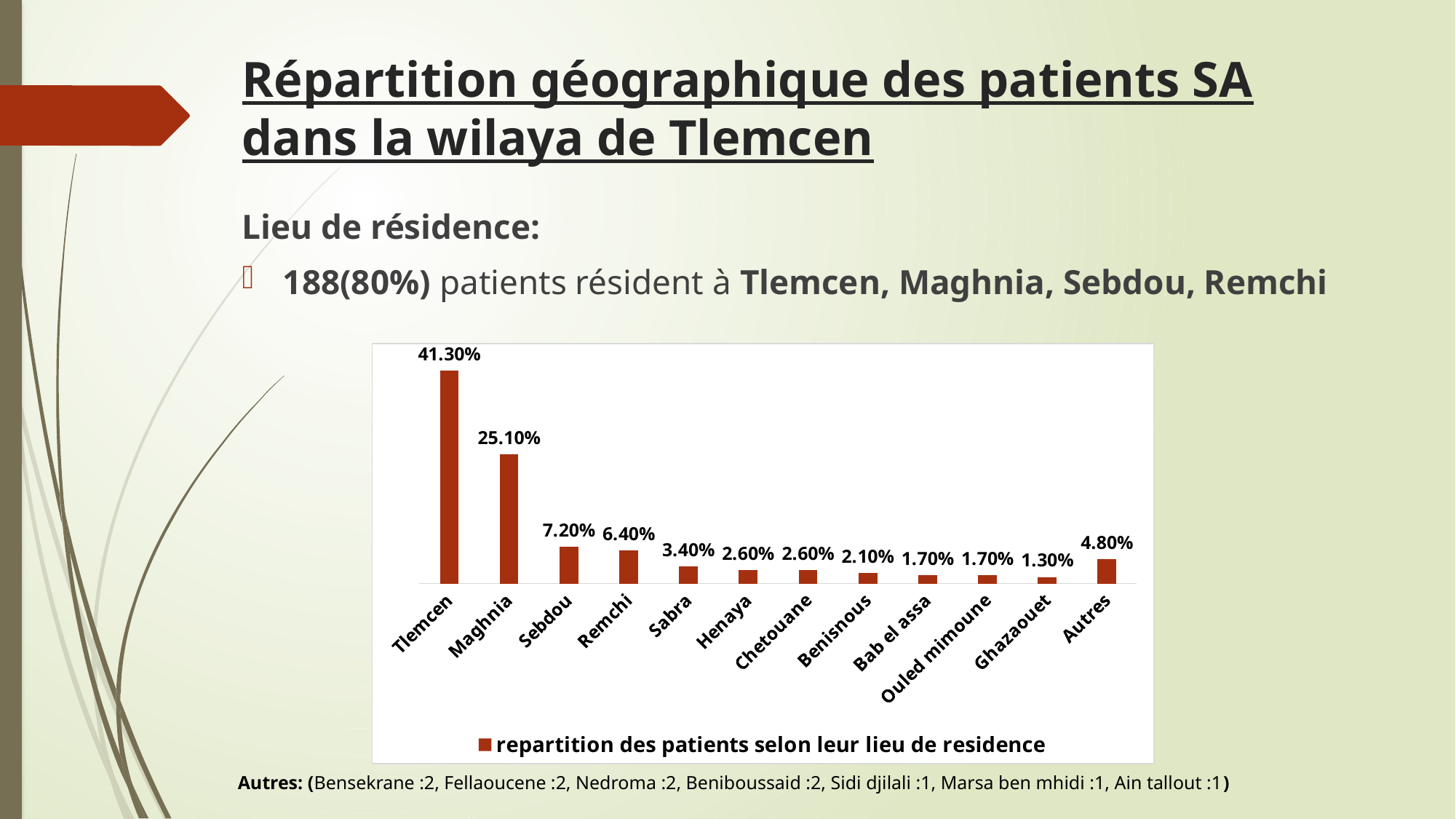
What is the legend entry of the chart? repartition des patients selon leur lieu de residence What kind of chart is shown on the slide? Bar chart What is the value for Ghazaouet? 1.30% What is the difference between the values for Tlemcen and Maghnia? 16.20% How many categories are shown on the x axis? 12 Which is larger, the value for Remchi or the value for Autres? Remchi What is the value for Tlemcen? 41.30% What is the value for Autres? 4.80% What is the value for Sebdou? 7.20% How many series does the legend list? 1 Which category has the highest value? Tlemcen Which category has the lowest value? Ghazaouet